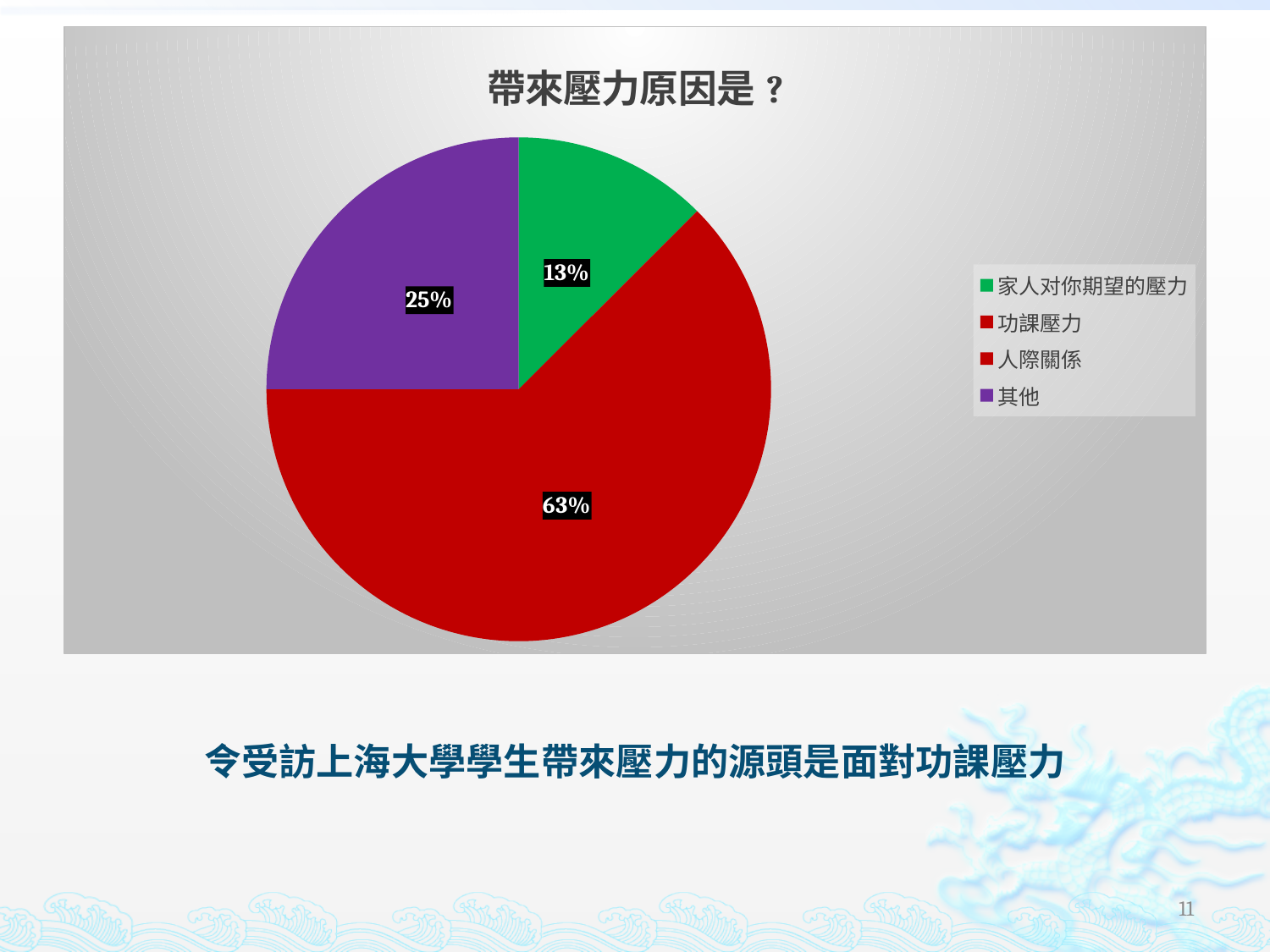
What is the difference between the largest slice (63%) and the 其他 slice? 38% Which category has the largest slice of the pie? 功課壓力 What percentage is shown for 家人对你期望的壓力? 13% What kind of chart is shown on the slide? pie chart How many entries does the legend list? 4 What is the title of the chart? 帶來壓力原因是？ What colour is the slice for 其他? purple What percentage is shown on the largest slice of the pie? 63% What is the difference between the 其他 slice and the 家人对你期望的壓力 slice? 12% Which is larger, the slice for 其他 or the slice for 家人对你期望的壓力? 其他 What percentage is shown for 其他? 25%